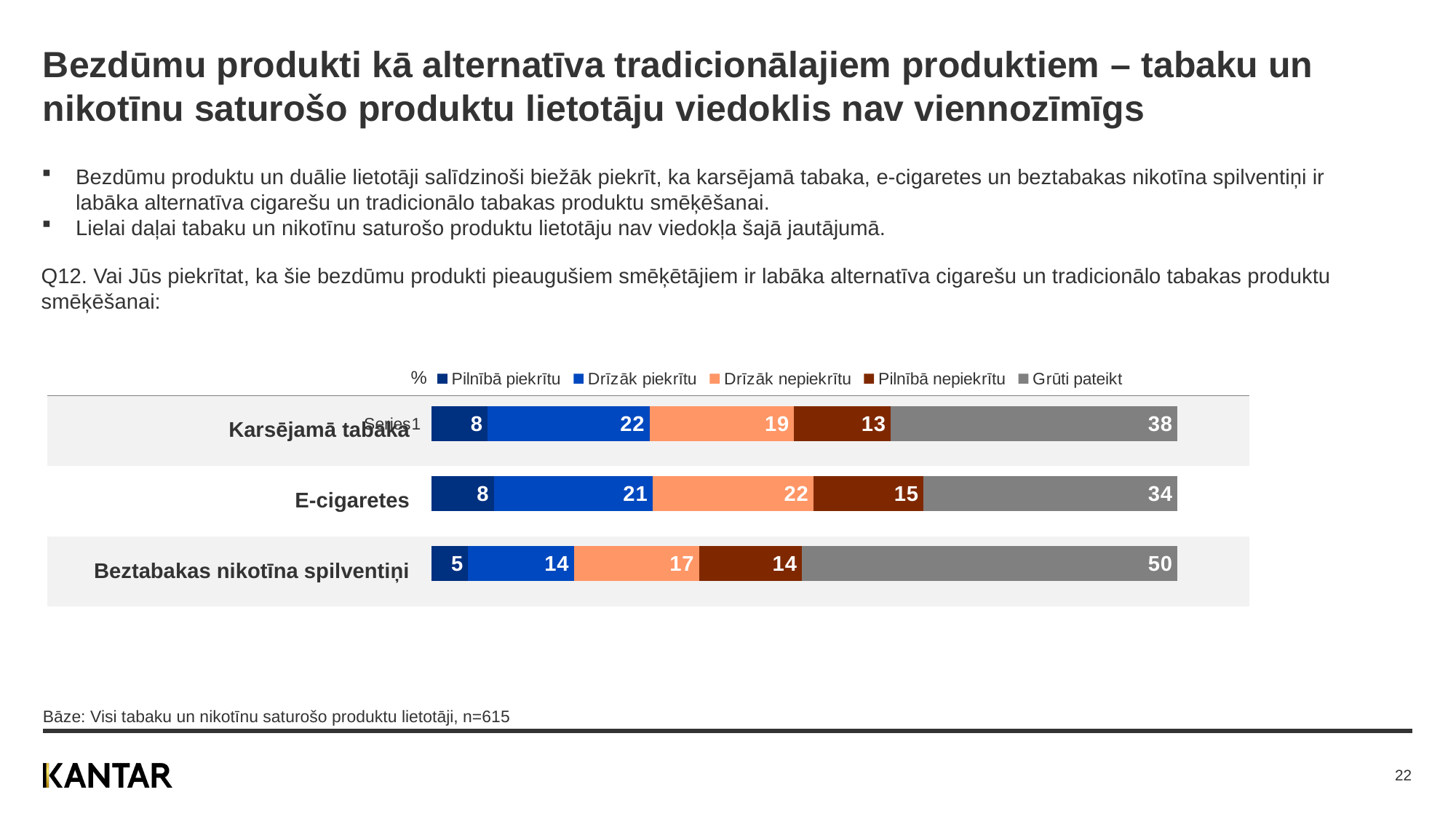
How many product categories are plotted in the chart? 3 Which legend entry is shown in grey? Grūti pateikt What is the 'Drīzāk piekrītu' value for Karsējamā tabaka? 22 What kind of chart is shown on the slide? Stacked bar chart What is the 'Grūti pateikt' value for Beztabakas nikotīna spilventiņi? 50 Which category has the lowest 'Pilnībā piekrītu' value? Beztabakas nikotīna spilventiņi How many series does the chart legend list? 5 Which category has the highest 'Grūti pateikt' value? Beztabakas nikotīna spilventiņi What is the total of the stacked bar for Karsējamā tabaka? 100 What is the 'Pilnībā nepiekrītu' value for E-cigaretes? 15 What is the difference between the 'Grūti pateikt' values for Beztabakas nikotīna spilventiņi and E-cigaretes? 16 Which is larger: the 'Drīzāk nepiekrītu' value for E-cigaretes or for Karsējamā tabaka? E-cigaretes